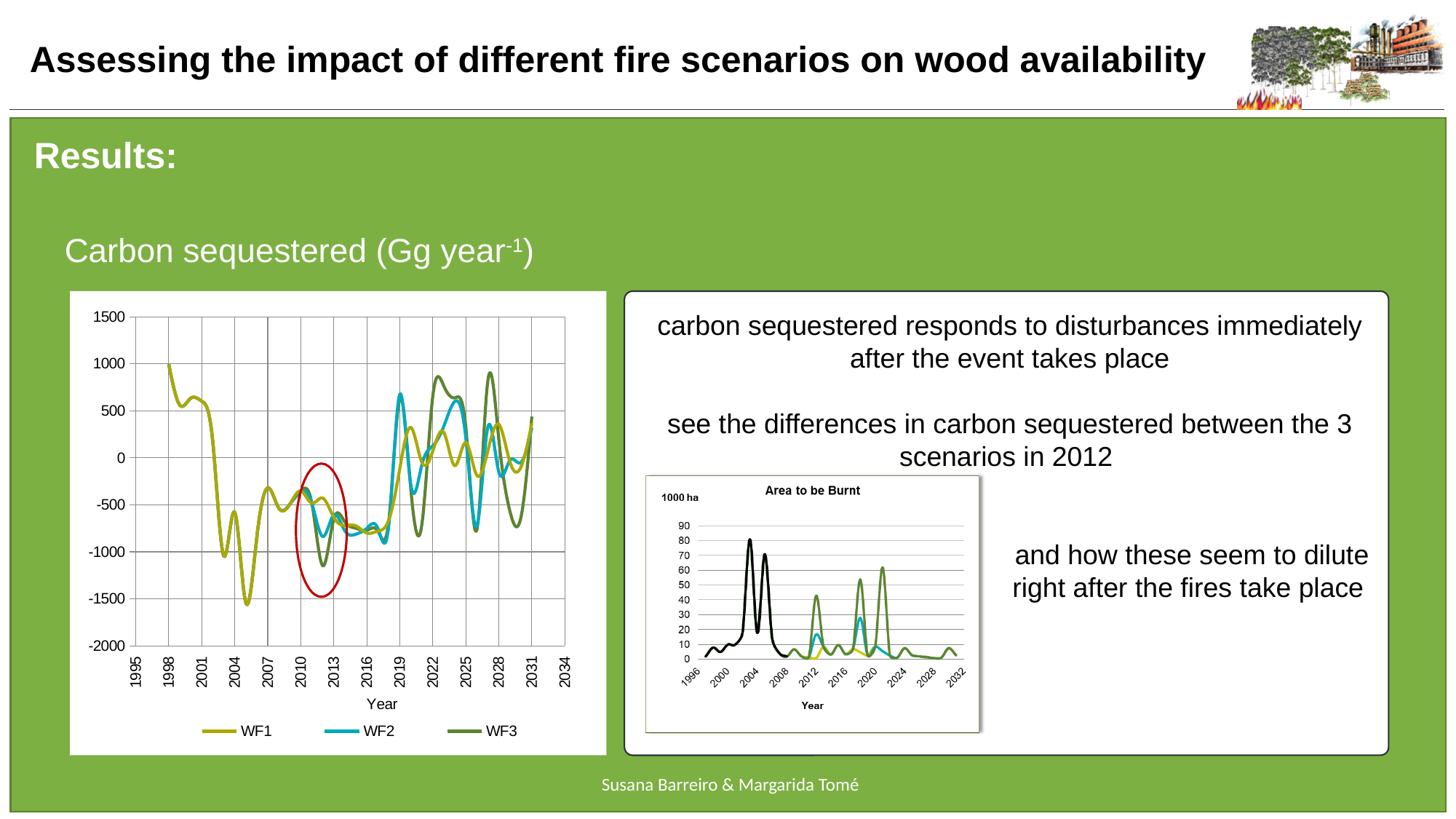
In the Carbon sequestered chart on the left, how many series does the legend list? 3 In the Carbon sequestered chart on the left, what kind of chart is used to show the data? line chart In the Carbon sequestered chart on the left, what are the names of the series in the legend? WF1, WF2, WF3 In the Area to be Burnt chart, is the highest peak of the black line (around 2003) greater or less than 70? greater In the Carbon sequestered chart on the left, around 2012, is the value for WF1 or WF3 larger? WF1 In the Carbon sequestered chart on the left, which scenario has the lowest value around 2012? WF3 In the Carbon sequestered chart on the left, is the value for WF1 around 2005 greater or less than -1000? less In the Carbon sequestered chart on the left, do the values fall or rise between 1998 and 2005? fall In the Area to be Burnt chart, is the green peak around 2021 greater or less than 50? greater What is the title of the small chart on the right? Area to be Burnt